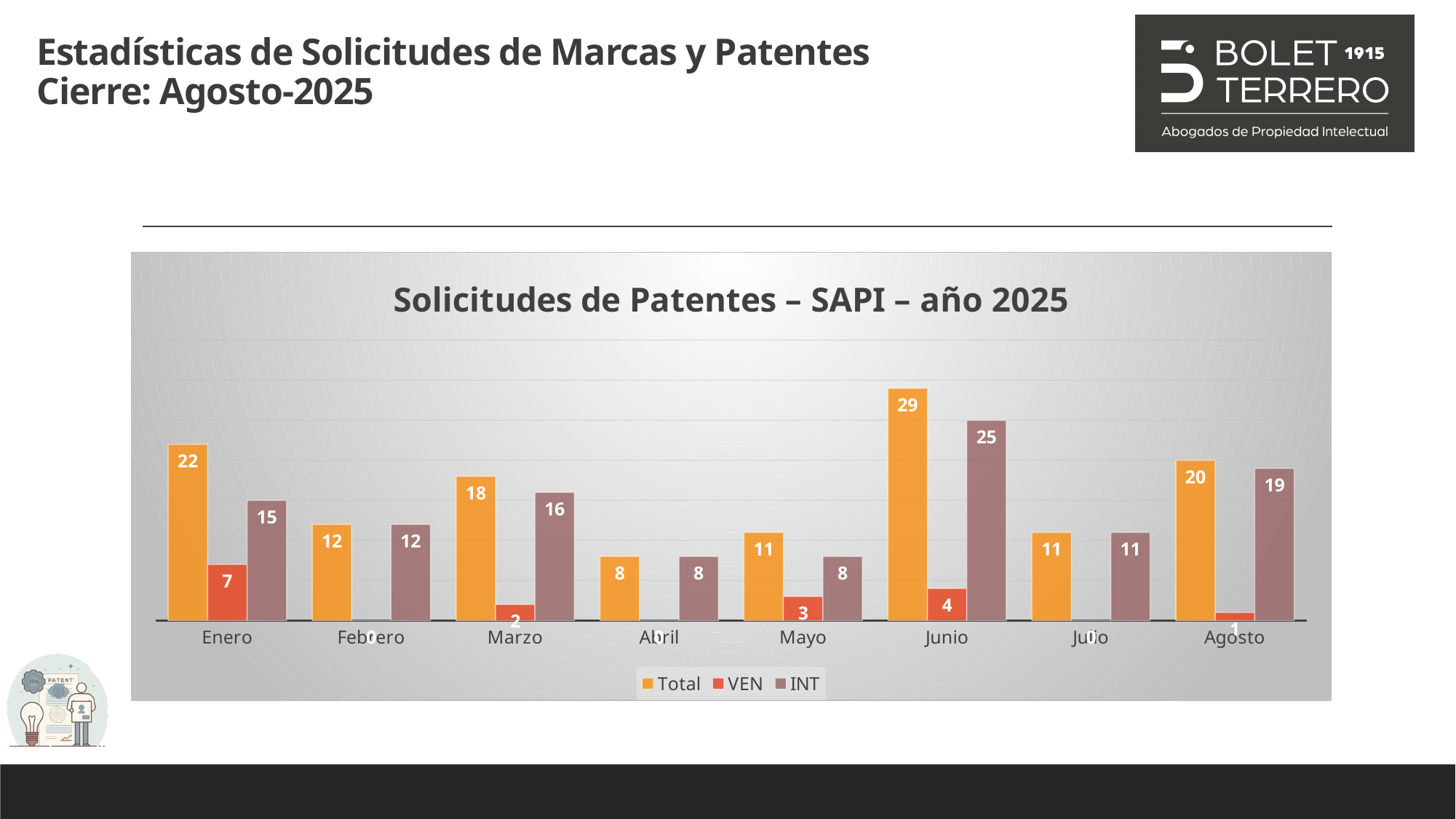
What is the difference between the Total values for Junio and Agosto? 9 What is the Total value for Junio? 29 What is the title of the chart? Solicitudes de Patentes – SAPI – año 2025 Which is larger, the INT value for Enero or the INT value for Febrero? Enero What is the VEN value for Enero? 7 How many months are shown on the x axis? 8 Which month has the lowest Total value? Abril What kind of chart is shown on the slide? Bar chart What is the difference between the Total and INT values for Mayo? 3 What is the INT value for Marzo? 16 Which month has the highest Total value? Junio How many series does the legend list? 3